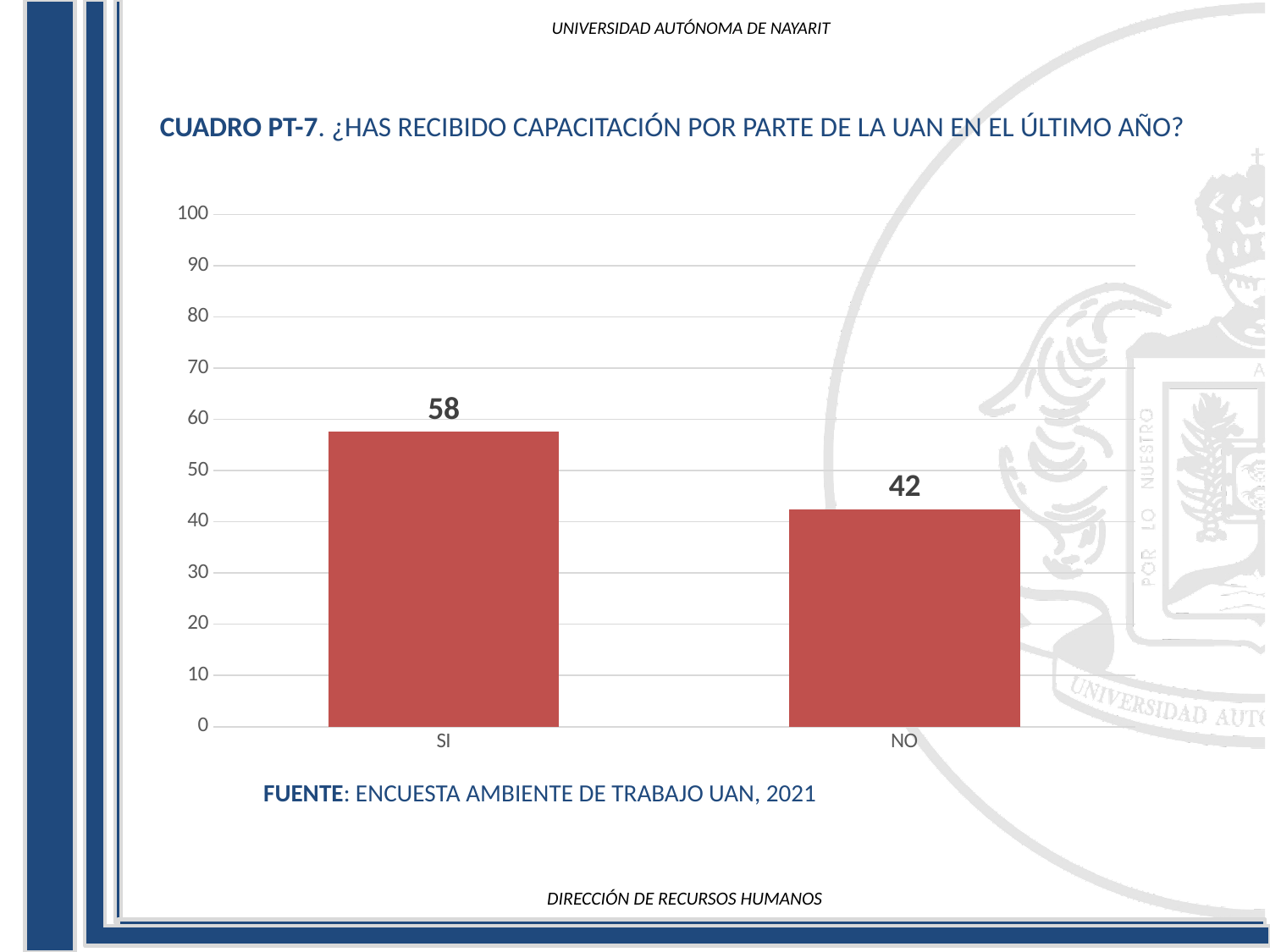
Is the value for SI greater or less than 50? greater Which category has the highest value? SI What is the difference between the values for SI and NO? 16 Which category has the lowest value? NO What is the value for SI? 58 What is the value for NO? 42 What is the total of the values for SI and NO? 100 Is the value for NO greater or less than 50? less What is the source cited below the chart? ENCUESTA AMBIENTE DE TRABAJO UAN, 2021 Which is larger, the value for SI or the value for NO? SI How many categories are shown on the x axis? 2 What kind of chart is shown on the slide? bar chart